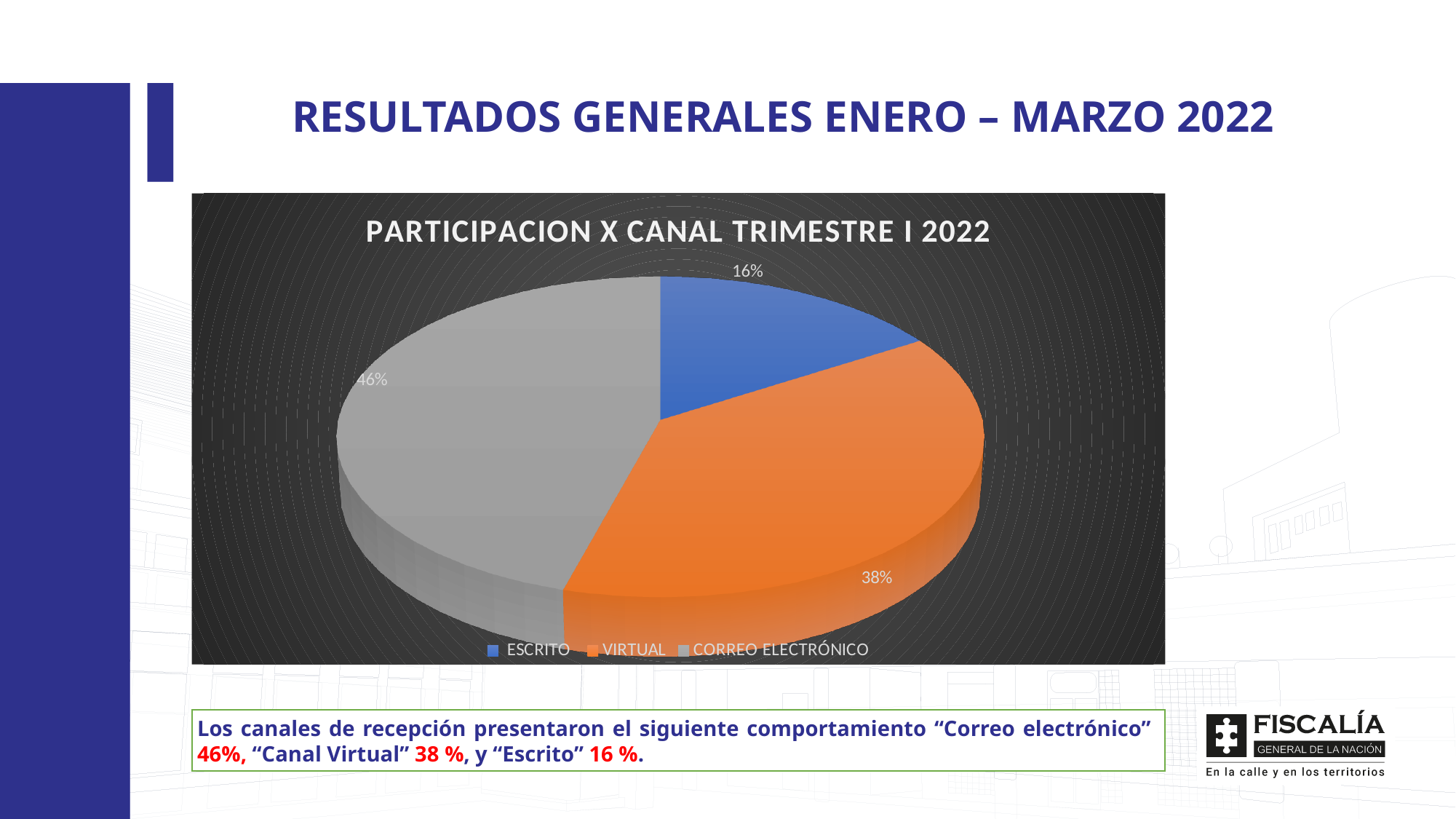
Which channel has the smallest share of the pie? ESCRITO What is the difference in percentage points between the CORREO ELECTRÓNICO and VIRTUAL shares? 8 What share of the pie does ESCRITO represent? 16% What is the title of the chart? PARTICIPACION X CANAL TRIMESTRE I 2022 How many entries does the legend list? 3 What is the difference in percentage points between the VIRTUAL and ESCRITO shares? 22 What share of the pie does VIRTUAL represent? 38% How many slices does the pie chart have? 3 Which has a larger share, VIRTUAL or ESCRITO? VIRTUAL Which channel has the largest share of the pie? CORREO ELECTRÓNICO What share of the pie does CORREO ELECTRÓNICO represent? 46% What kind of chart is shown on the slide? Pie chart